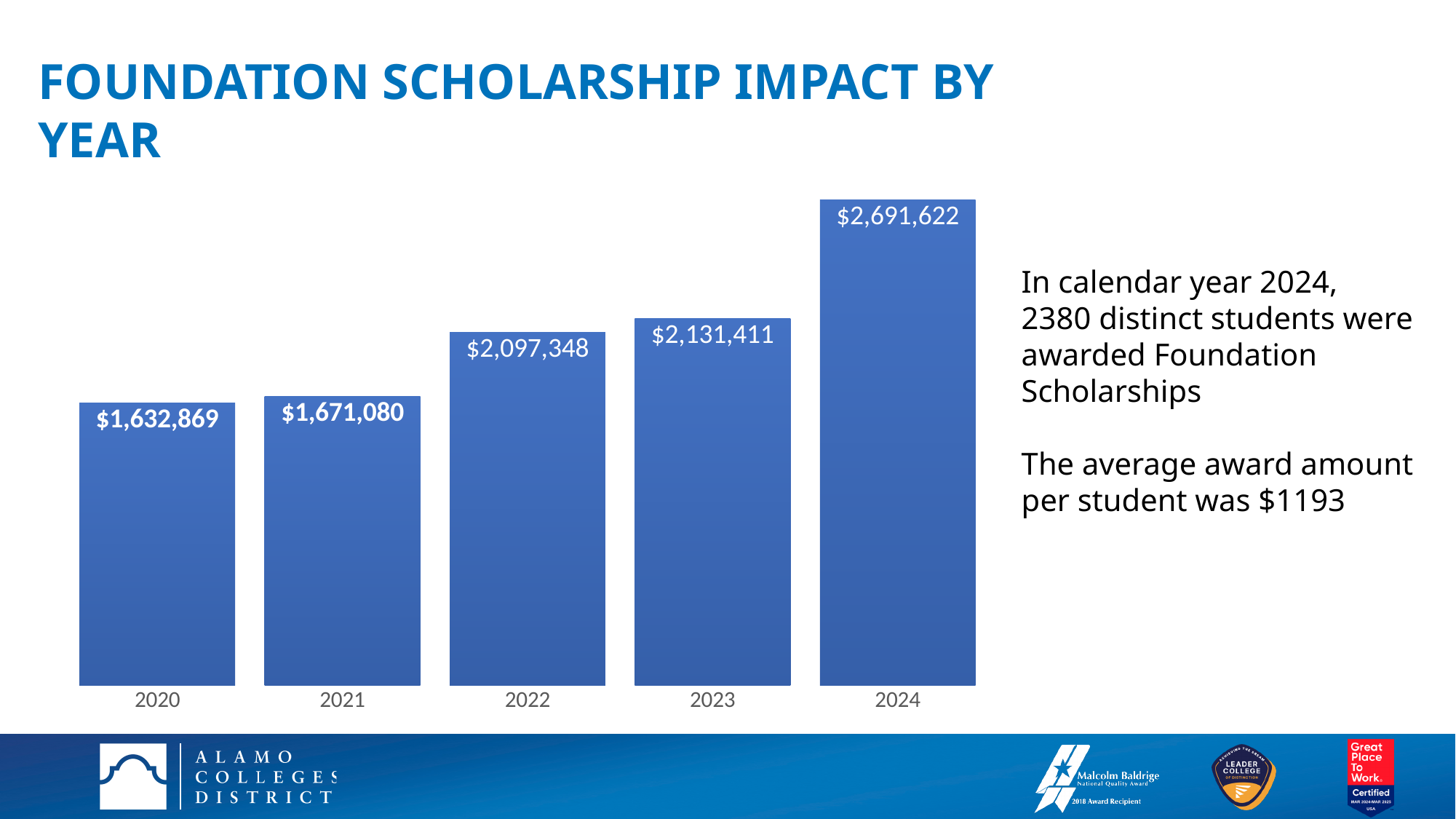
What is the difference between the 2021 and 2020 scholarship amounts? $38,211 How many years are shown in the chart? 5 Do the scholarship amounts rise or fall from 2020 to 2024? Rise What was the Foundation Scholarship amount for 2022? $2,097,348 Which year had a larger scholarship amount, 2022 or 2023? 2023 What type of chart is shown on the slide? Bar chart What was the Foundation Scholarship amount for 2024? $2,691,622 What is the difference between the 2024 and 2023 scholarship amounts? $560,211 Which year has the highest scholarship amount? 2024 What was the Foundation Scholarship amount for 2020? $1,632,869 Which year has the lowest scholarship amount? 2020 What is the title of the slide containing the chart? FOUNDATION SCHOLARSHIP IMPACT BY YEAR